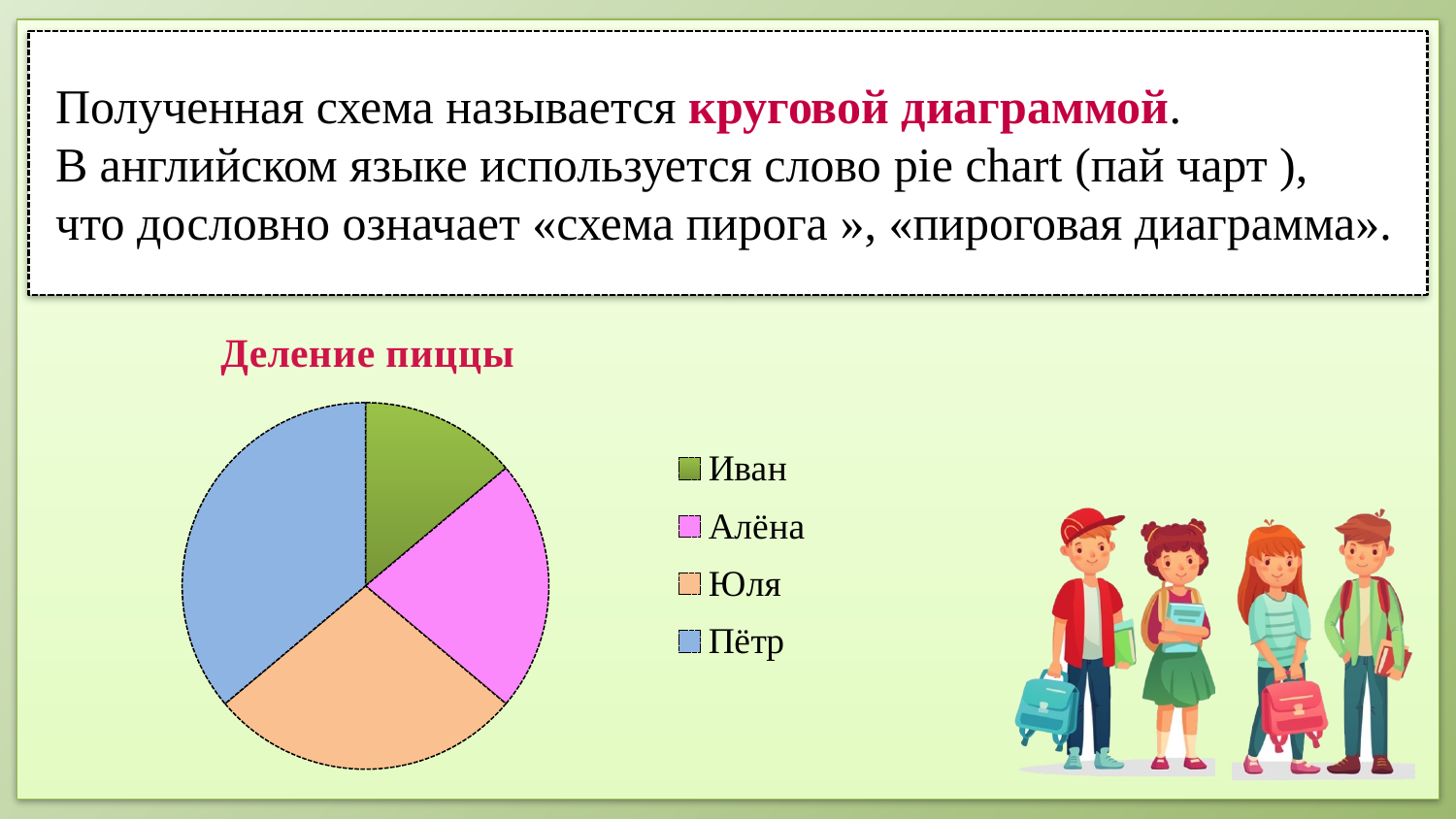
How many slices does the pie chart have? 4 Which slice is larger in the pie chart, Пётр or Юля? Пётр What is the title of the pie chart? Деление пиццы Which person has the smallest slice of the pizza in the pie chart? Иван Which slice is larger in the pie chart, Алёна or Иван? Алёна Which slice is larger in the pie chart, Пётр or Иван? Пётр How many entries does the legend of the pie chart list? 4 Which person has the largest slice of the pizza in the pie chart? Пётр Which colour represents Юля in the pie chart? orange What kind of chart is shown on the slide? pie chart